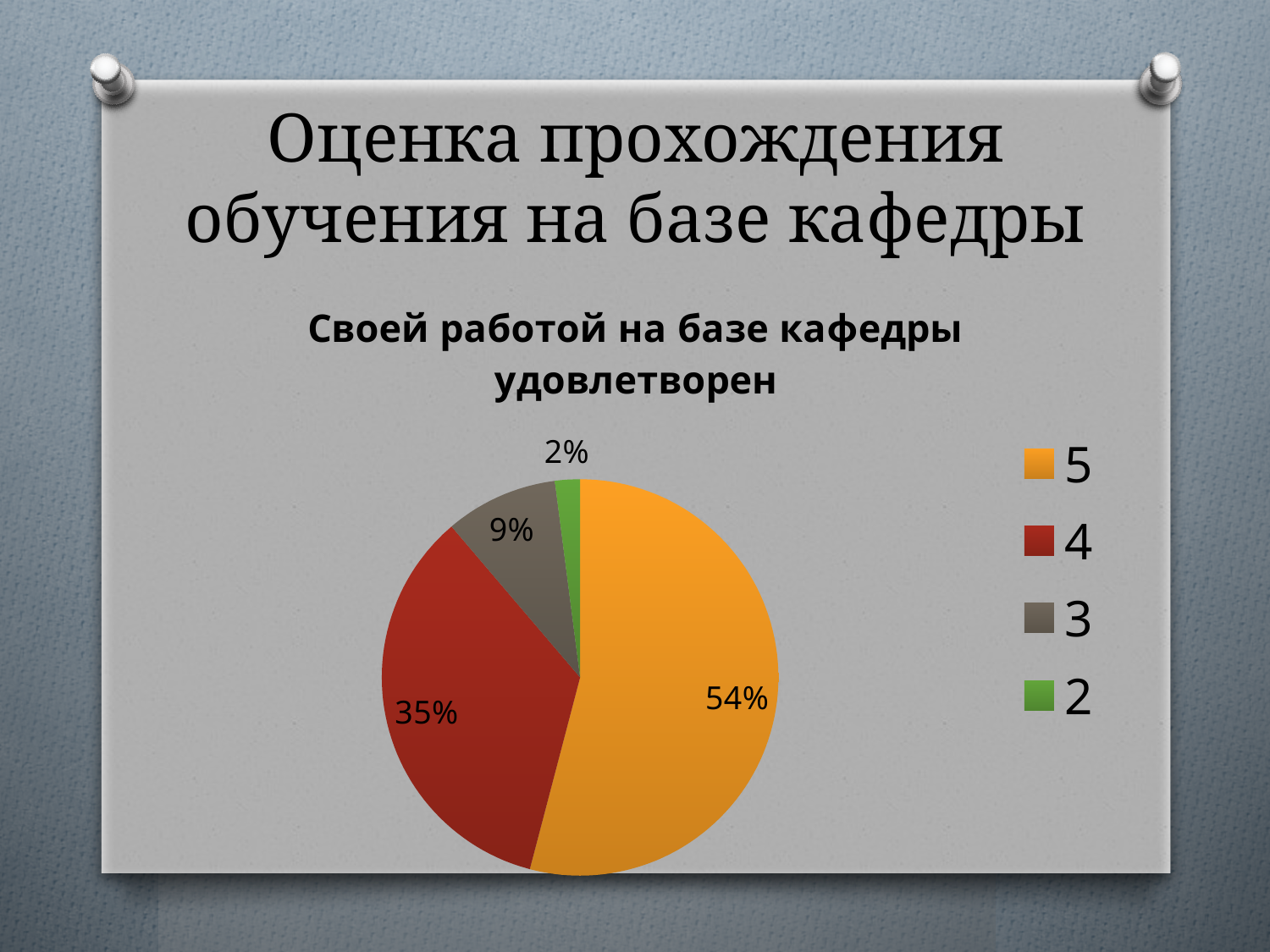
What share of the pie does the slice for rating 3 represent? 9% What kind of chart is shown on the slide? Pie chart What share of the pie does the slice for rating 2 represent? 2% Which rating has the largest slice of the pie? 5 Which slice is larger, rating 3 or rating 2? 3 What is the title of the chart? Своей работой на базе кафедры удовлетворен How many slices does the pie chart have? 4 What share of the pie does the slice for rating 4 represent? 35% Which rating has the smallest slice of the pie? 2 What is the difference in percentage points between the slices for rating 5 and rating 4? 19 percentage points What colour is the slice for rating 4? Red